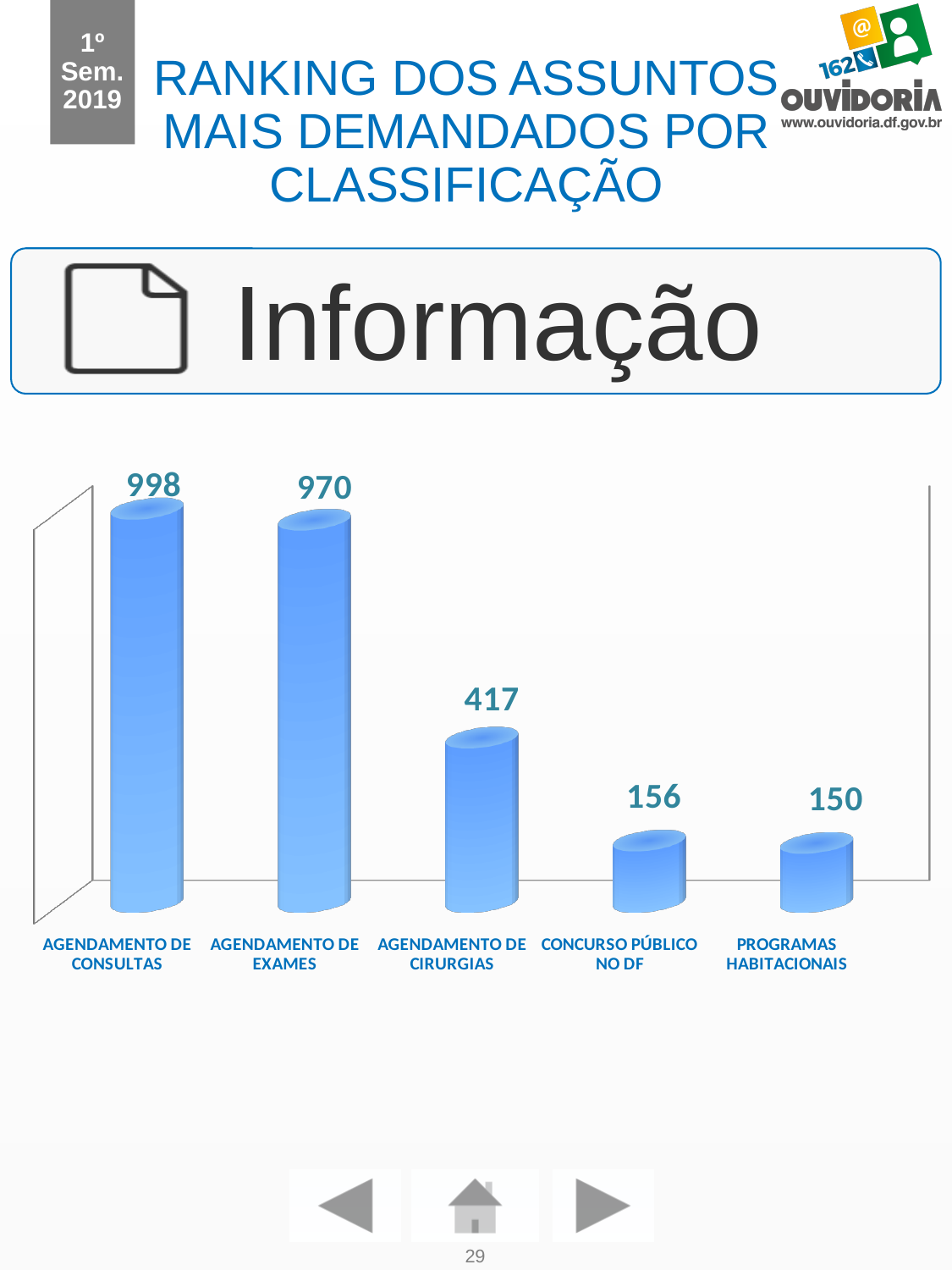
Which category has the highest value? AGENDAMENTO DE CONSULTAS What is the value for AGENDAMENTO DE CIRURGIAS? 417 How many categories are shown in the chart? 5 What is the difference between the values for AGENDAMENTO DE EXAMES and AGENDAMENTO DE CIRURGIAS? 553 Which is larger, the value for AGENDAMENTO DE CIRURGIAS or the value for CONCURSO PÚBLICO NO DF? AGENDAMENTO DE CIRURGIAS What is the value for CONCURSO PÚBLICO NO DF? 156 Which category has the lowest value? PROGRAMAS HABITACIONAIS What is the value for AGENDAMENTO DE EXAMES? 970 What is the difference between the values for AGENDAMENTO DE CONSULTAS and AGENDAMENTO DE EXAMES? 28 What is the value for AGENDAMENTO DE CONSULTAS? 998 What kind of chart is shown on the slide? Bar chart What is the value for PROGRAMAS HABITACIONAIS? 150